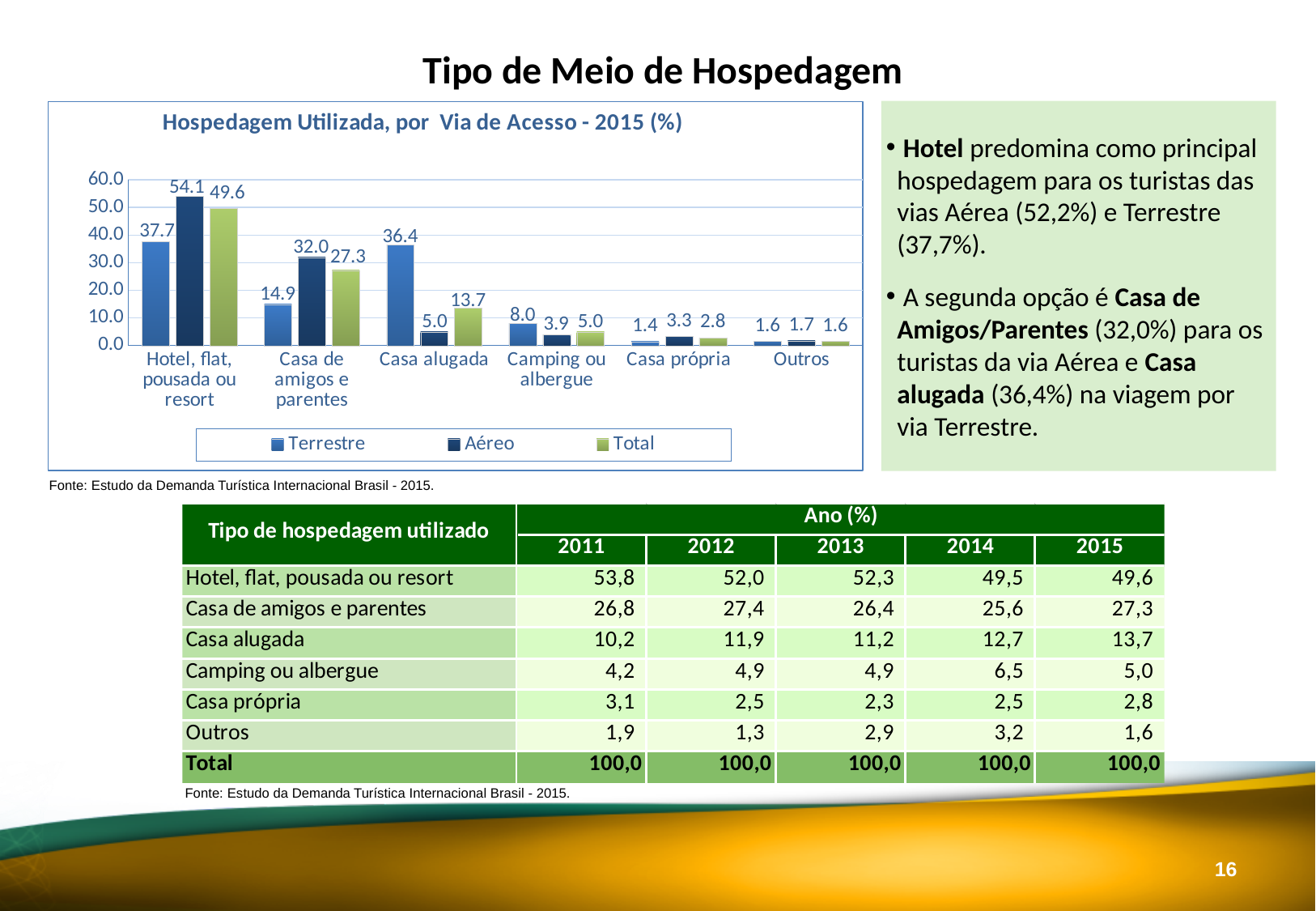
What type of chart is shown on the slide? Bar chart How many series does the chart legend list? 3 What is the Aéreo value for Casa de amigos e parentes in the chart? 32.0 What is the Terrestre value for Hotel, flat, pousada ou resort in the chart? 37.7 Is the Total value for Casa de amigos e parentes greater or less than 20.0? greater Which category has the lowest Terrestre value in the chart? Casa própria Which category has the highest Aéreo value in the chart? Hotel, flat, pousada ou resort What is the title of the chart? Hospedagem Utilizada, por Via de Acesso - 2015 (%) What is the difference between the Aéreo and Terrestre values for Hotel, flat, pousada ou resort? 16.4 How many accommodation categories are shown on the x axis of the chart? 6 For Casa alugada, which is larger: the Terrestre value or the Aéreo value? Terrestre What is the Total value for Casa alugada in the chart? 13.7